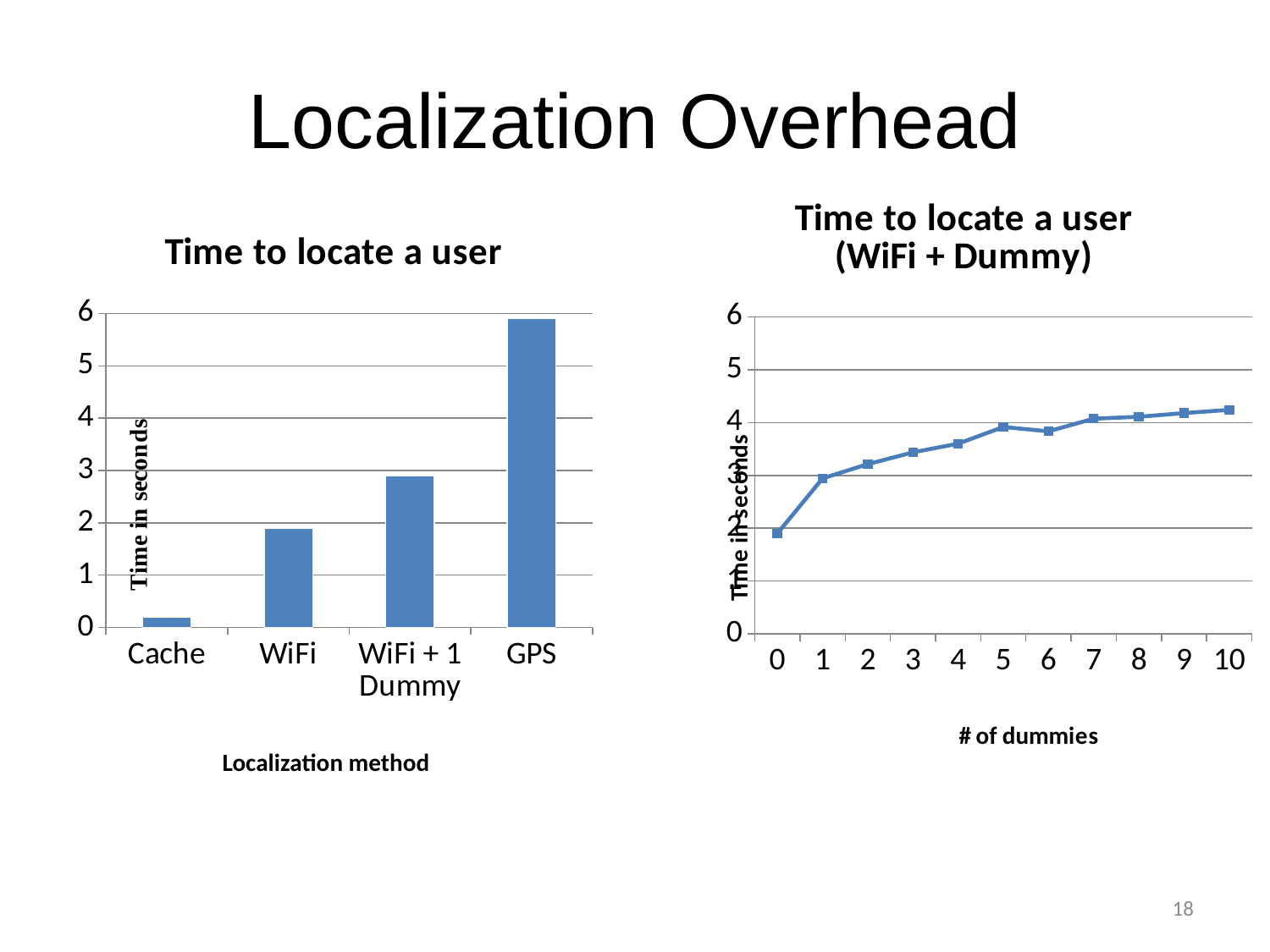
In the chart titled "Time to locate a user" on the left, what kind of chart is shown? bar chart In the left chart "Time to locate a user", which localization method has the lowest time? Cache In the chart titled "Time to locate a user (WiFi + Dummy)" on the right, what kind of chart is shown? line chart In the left chart "Time to locate a user", is the value for GPS greater or less than 5? greater How many localization methods are shown in the left chart "Time to locate a user"? 4 In the right chart "Time to locate a user (WiFi + Dummy)", does the time generally rise or fall as the number of dummies increases? rise What is the x-axis title of the right chart "Time to locate a user (WiFi + Dummy)"? # of dummies In the right chart "Time to locate a user (WiFi + Dummy)", is the value at 10 dummies greater or less than 4? greater In the left chart "Time to locate a user", which is larger, the value for WiFi or the value for WiFi + 1 Dummy? WiFi + 1 Dummy In the left chart "Time to locate a user", which localization method has the highest time? GPS